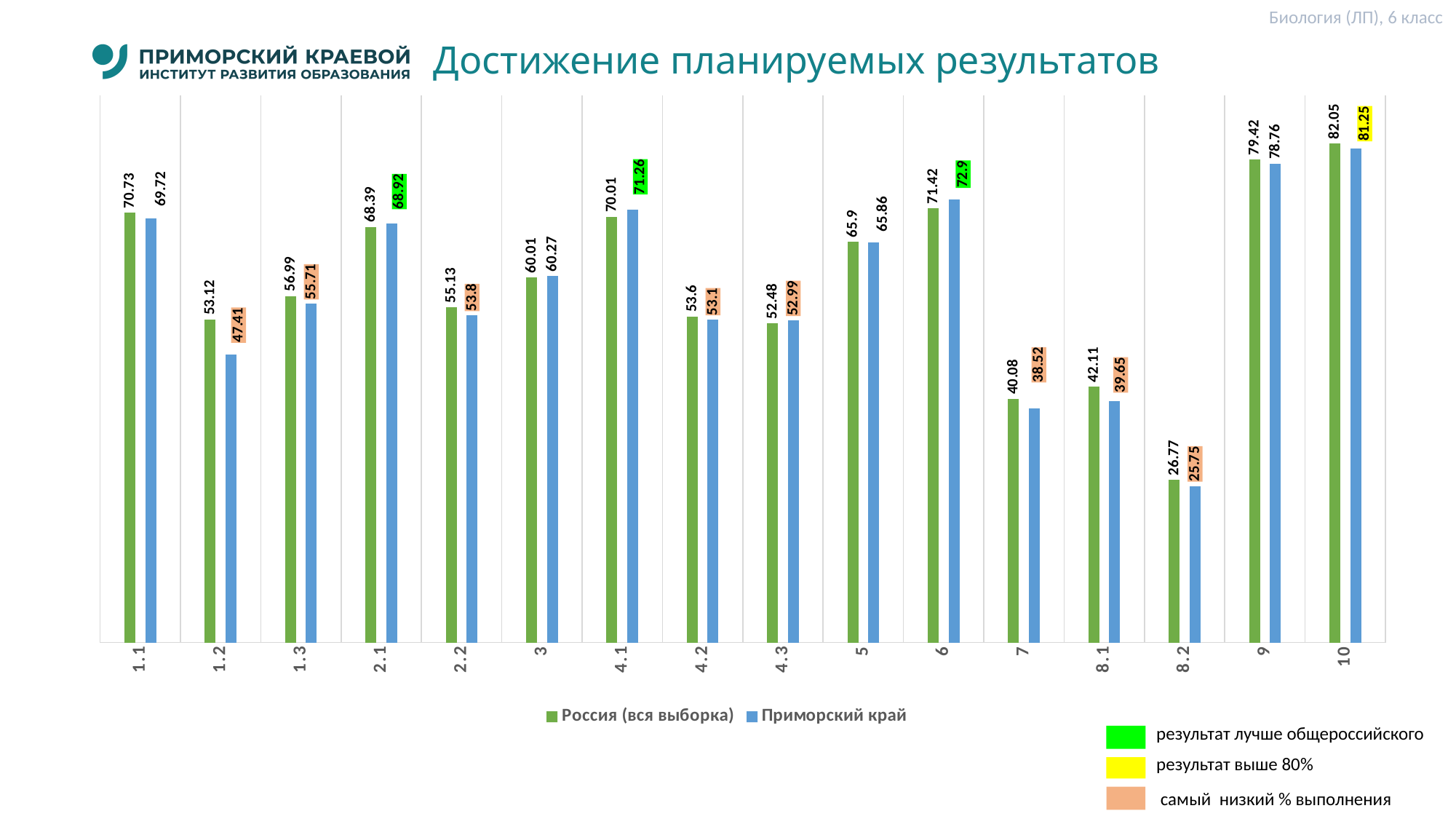
Which is larger for Приморский край: category 9 or category 8.1? 9 What kind of chart is shown on the slide? bar chart What is the value for Приморский край for category 4.1? 71.26 What is the value for Приморский край for category 1.2? 47.41 For category 7, which series has the larger value: Россия (вся выборка) or Приморский край? Россия (вся выборка) Which category has the lowest value for Россия (вся выборка)? 8.2 What is the difference between Россия (вся выборка) and Приморский край for category 1.2? 5.71 How many categories are shown on the x axis? 16 What is the difference between Россия (вся выборка) and Приморский край for category 10? 0.8 Which category has the highest value for Приморский край? 10 How many series does the legend list? 2 What is the value for Россия (вся выборка) for category 6? 71.42